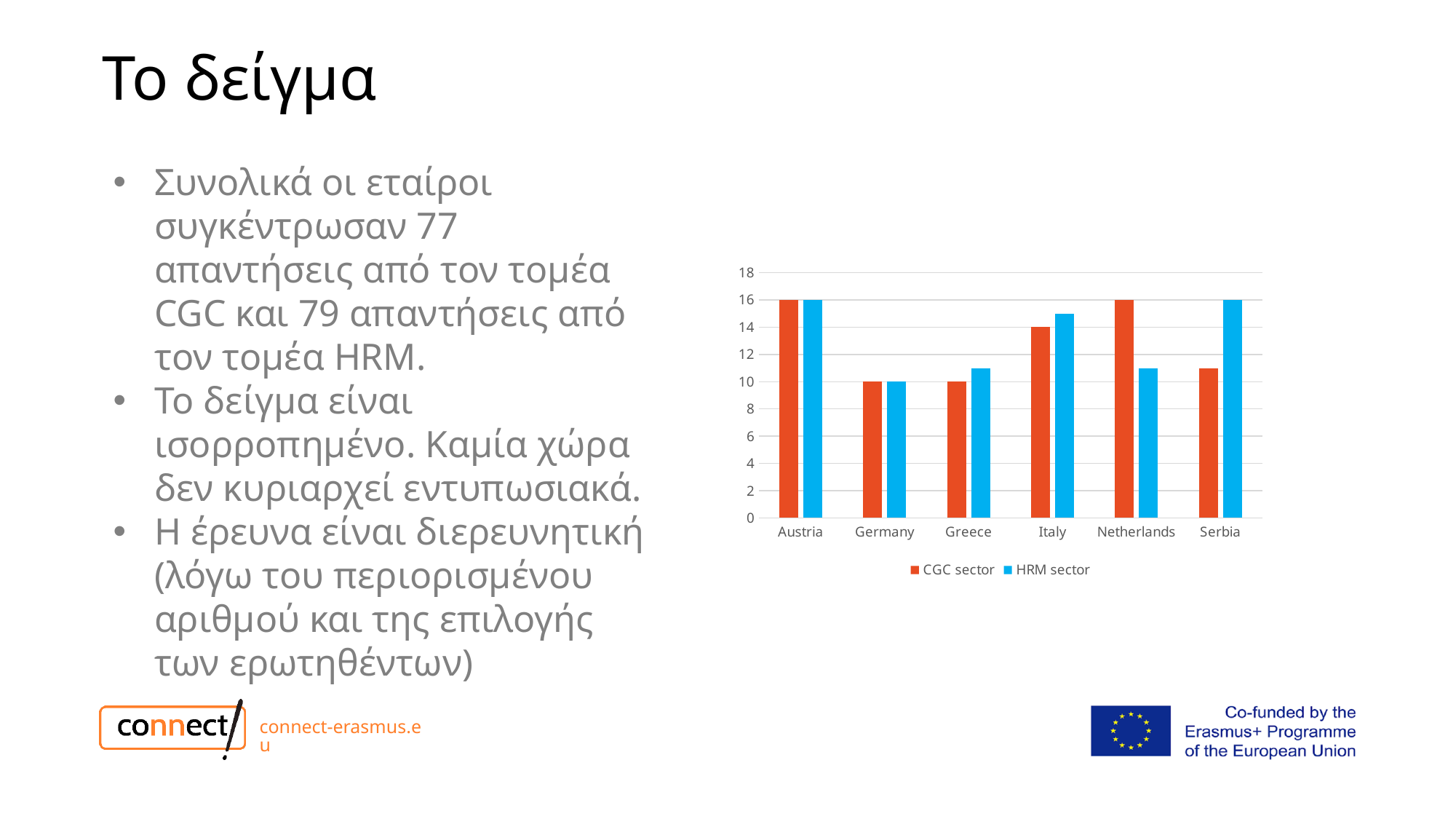
How many series does the chart legend list? 2 In Netherlands, which series has the larger value, CGC sector or HRM sector? CGC sector Which is larger for Italy, the CGC sector value or the Greece CGC sector value? Italy What is the difference between the CGC sector values for Netherlands and Germany? 6 What is the value for the CGC sector in Italy? 14 What kind of chart is shown on the slide? bar chart Is the value for the CGC sector in Serbia greater or less than 12? less Is the value for the HRM sector in Italy greater or less than 12? greater How many countries are shown on the x axis of the chart? 6 What is the value for the HRM sector in Germany? 10 What is the value for the CGC sector in Austria? 16 What is the value for the HRM sector in Serbia? 16